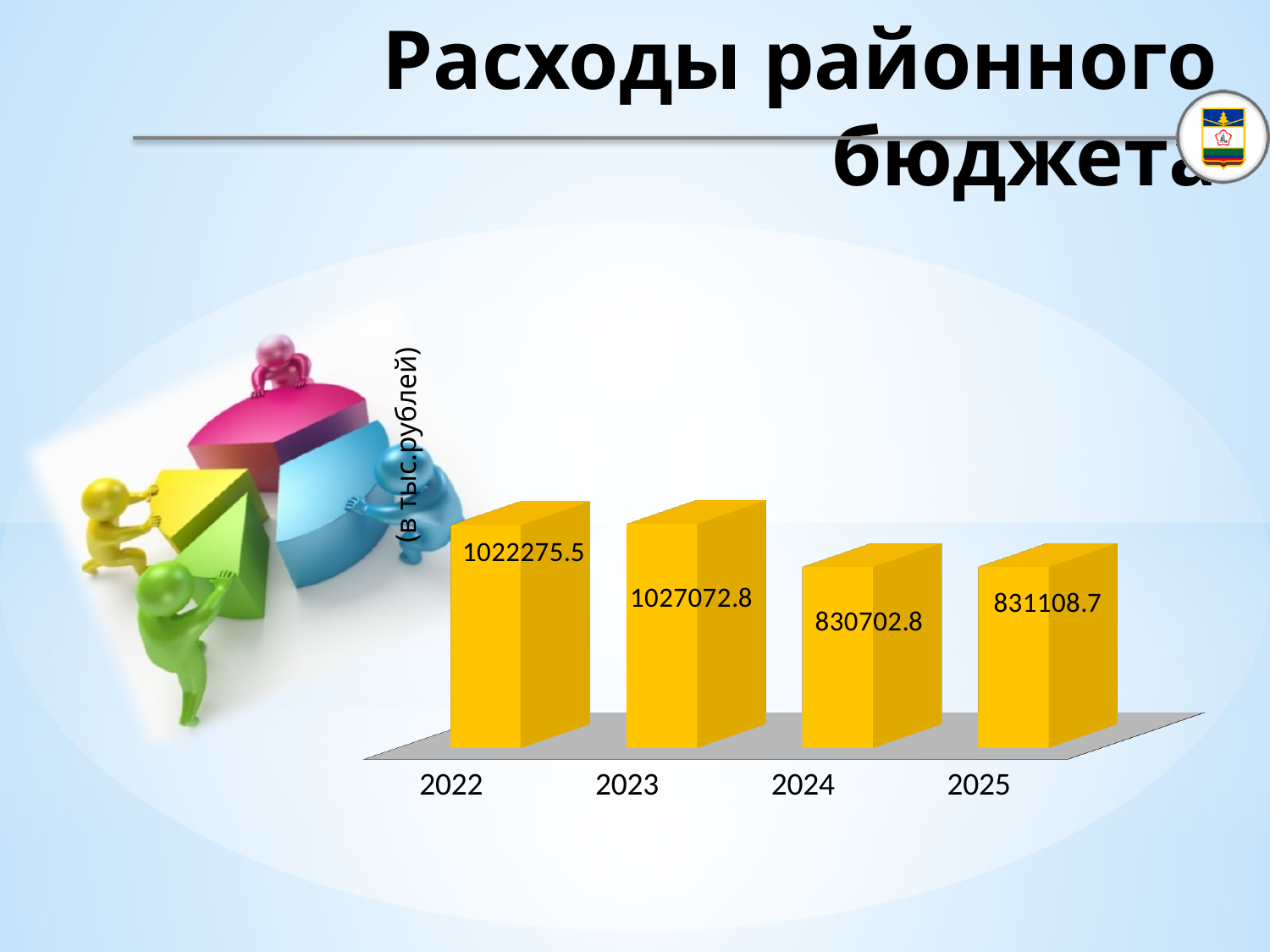
What is the difference between the values for 2022 and 2024? 191572.7 What is the value for 2022? 1022275.5 What is the value for 2025? 831108.7 What is the value for 2024? 830702.8 What kind of chart is shown on the slide? Bar chart Which is larger, the value for 2023 or the value for 2024? 2023 Which year has the lowest value? 2024 What is the title of the slide? Расходы районного бюджета How many years are shown on the chart? 4 What is the value for 2023? 1027072.8 What is the difference between the values for 2023 and 2022? 4797.3 Which year has the highest value? 2023